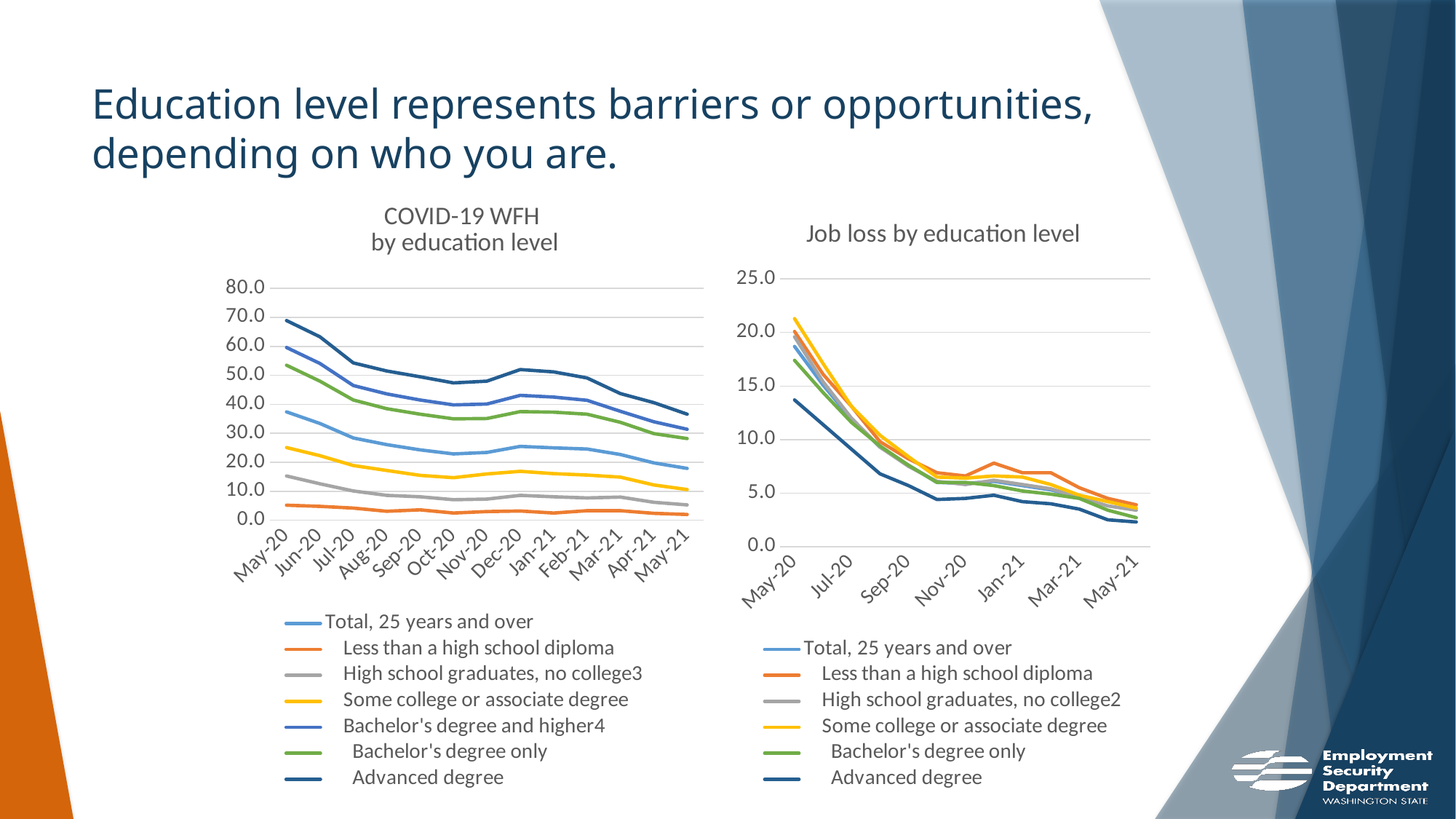
In the "COVID-19 WFH by education level" chart, is the value for Less than a high school diploma in May-20 greater or less than 10? less In the "Job loss by education level" chart, do the values generally rise or fall from May-20 to May-21? fall In the "Job loss by education level" chart, which series has the lowest value in May-20? Advanced degree What type of chart is the "COVID-19 WFH by education level" chart? line chart In the "COVID-19 WFH by education level" chart, which series has the lowest value in May-20? Less than a high school diploma In the "COVID-19 WFH by education level" chart, which is higher in May-20: Bachelor's degree only or Total, 25 years and over? Bachelor's degree only How many months are shown on the x axis of the "COVID-19 WFH by education level" chart? 13 In the "COVID-19 WFH by education level" chart, is the value for Advanced degree in May-20 greater or less than 60? greater How many series does the legend of the "Job loss by education level" chart list? 6 In the "Job loss by education level" chart, is the value for Advanced degree in May-20 greater or less than 15? less In the "COVID-19 WFH by education level" chart, which series has the highest value in May-20? Advanced degree How many series does the legend of the "COVID-19 WFH by education level" chart list? 7